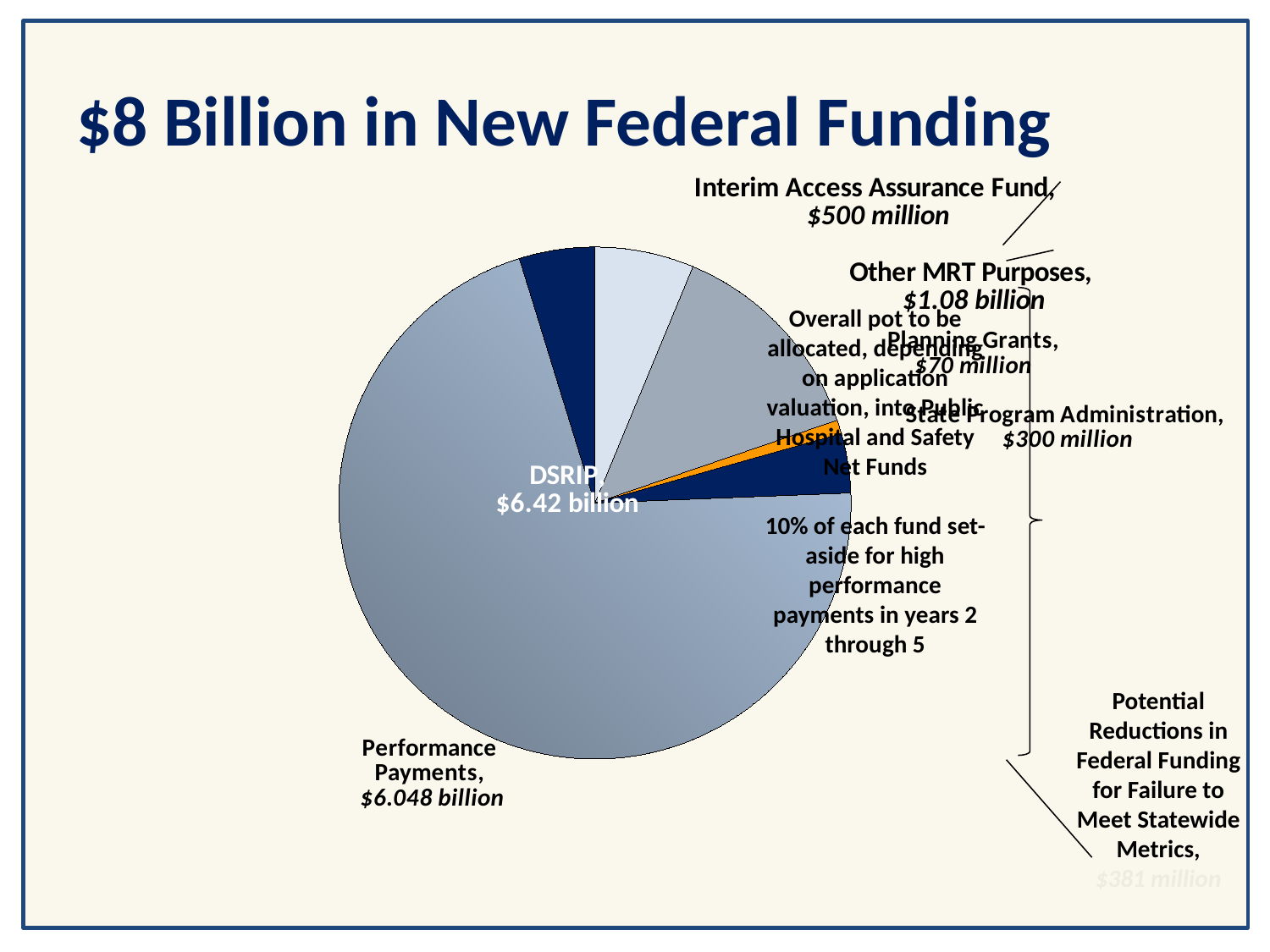
What is the value shown for the Interim Access Assurance Fund slice? $500 million What is the value shown for State Program Administration? $300 million What is the title of the slide containing the chart? $8 Billion in New Federal Funding What value is shown for DSRIP? $6.42 billion What kind of chart is shown on the slide? Pie chart What is the value shown for Performance Payments? $6.048 billion Which labelled slice of the pie is the smallest? Planning Grants Which is larger, the Interim Access Assurance Fund or State Program Administration? Interim Access Assurance Fund What is the value shown for Planning Grants? $70 million How much larger is the Interim Access Assurance Fund than State Program Administration? $200 million What value is shown for Potential Reductions in Federal Funding for Failure to Meet Statewide Metrics? $381 million What is the value shown for Other MRT Purposes? $1.08 billion